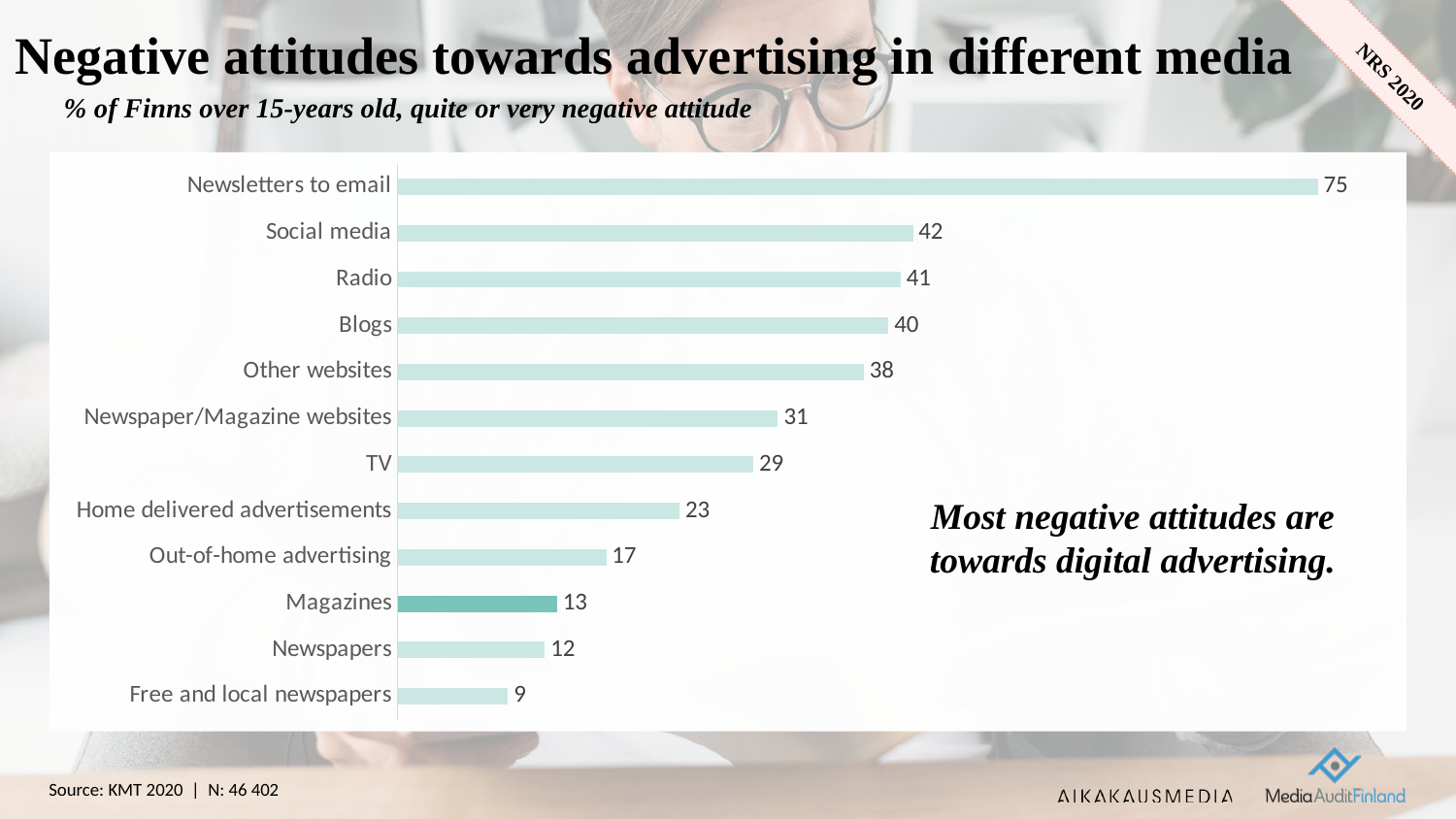
What is the difference between the values for Newsletters to email and Free and local newspapers? 66 Which category has the highest value? Newsletters to email Which has a larger value, Radio or Out-of-home advertising? Radio What is the difference between the values for Social media and TV? 13 What is the title of the chart? Negative attitudes towards advertising in different media What is the value for Magazines? 13 What is the value for Newspaper/Magazine websites? 31 Which bar is shown in a darker colour than the others? Magazines What is the value for Newsletters to email? 75 How many categories are shown in the chart? 12 Which category has the lowest value? Free and local newspapers What kind of chart is shown on the slide? Bar chart